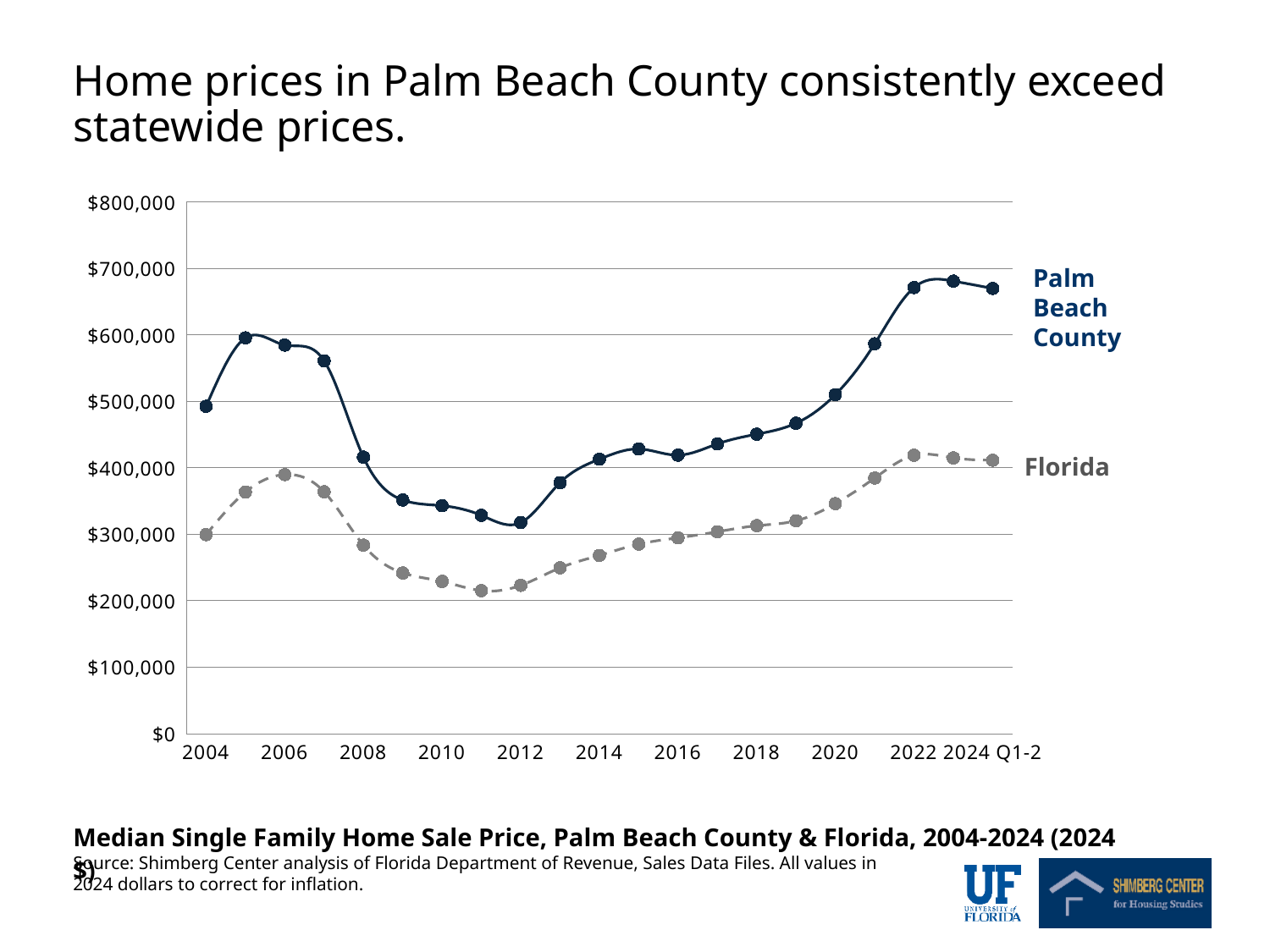
Is the Florida value for 2006 greater or less than $400,000? less What is the title of the chart? Median Single Family Home Sale Price, Palm Beach County & Florida, 2004-2024 (2024 $) Which series is drawn with a dashed grey line? Florida Is the Florida value for 2011 greater or less than $200,000? greater What kind of chart is shown on the slide? Line chart Is the Palm Beach County value for 2012 greater or less than $300,000? greater Which is larger for Palm Beach County, the value in 2005 or the value in 2012? 2005 Do Palm Beach County prices rise or fall between 2012 and 2022? Rise How many series are plotted on the chart? 2 Which series has the higher value in 2020, Palm Beach County or Florida? Palm Beach County Do Florida prices rise or fall between 2006 and 2011? Fall